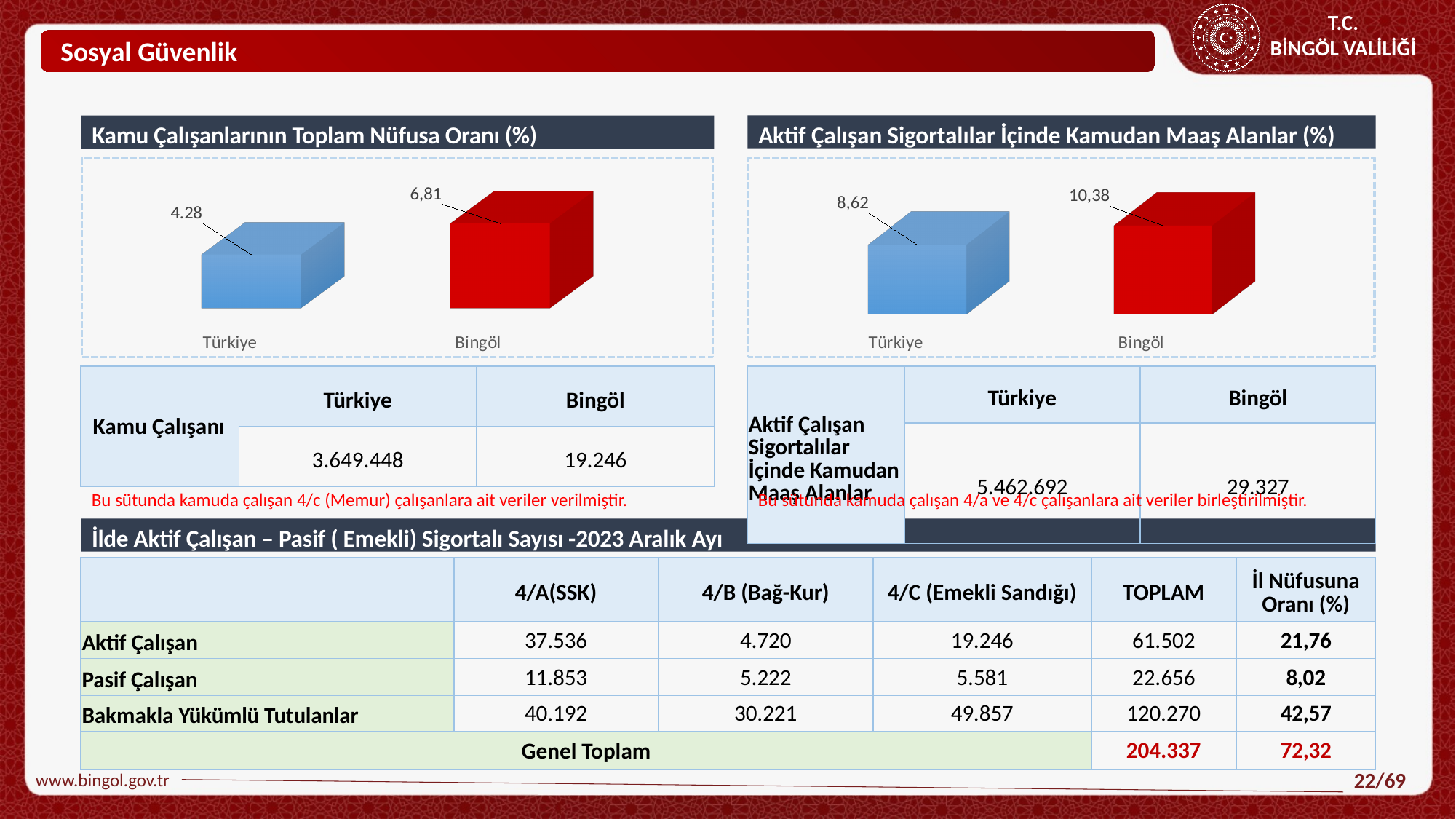
In the chart titled 'Kamu Çalışanlarının Toplam Nüfusa Oranı (%)', what is the value for Bingöl? 6,81 In the chart titled 'Aktif Çalışan Sigortalılar İçinde Kamudan Maaş Alanlar (%)', which category has the lower value? Türkiye In the chart titled 'Aktif Çalışan Sigortalılar İçinde Kamudan Maaş Alanlar (%)', what is the difference between the Bingöl and Türkiye values? 1,76 In the chart titled 'Aktif Çalışan Sigortalılar İçinde Kamudan Maaş Alanlar (%)', what is the value for Bingöl? 10,38 In the chart titled 'Kamu Çalışanlarının Toplam Nüfusa Oranı (%)', which category has the higher value? Bingöl In the chart titled 'Kamu Çalışanlarının Toplam Nüfusa Oranı (%)', what colour is the bar for Türkiye? blue How many categories are shown in the chart titled 'Kamu Çalışanlarının Toplam Nüfusa Oranı (%)'? 2 In the chart titled 'Kamu Çalışanlarının Toplam Nüfusa Oranı (%)', is the value for Türkiye larger or smaller than the value for Bingöl? smaller What kind of chart is the one titled 'Aktif Çalışan Sigortalılar İçinde Kamudan Maaş Alanlar (%)'? bar chart In the chart titled 'Aktif Çalışan Sigortalılar İçinde Kamudan Maaş Alanlar (%)', what is the value for Türkiye? 8,62 In the chart titled 'Kamu Çalışanlarının Toplam Nüfusa Oranı (%)', what is the value for Türkiye? 4.28 In the chart titled 'Aktif Çalışan Sigortalılar İçinde Kamudan Maaş Alanlar (%)', what colour is the bar for Bingöl? red